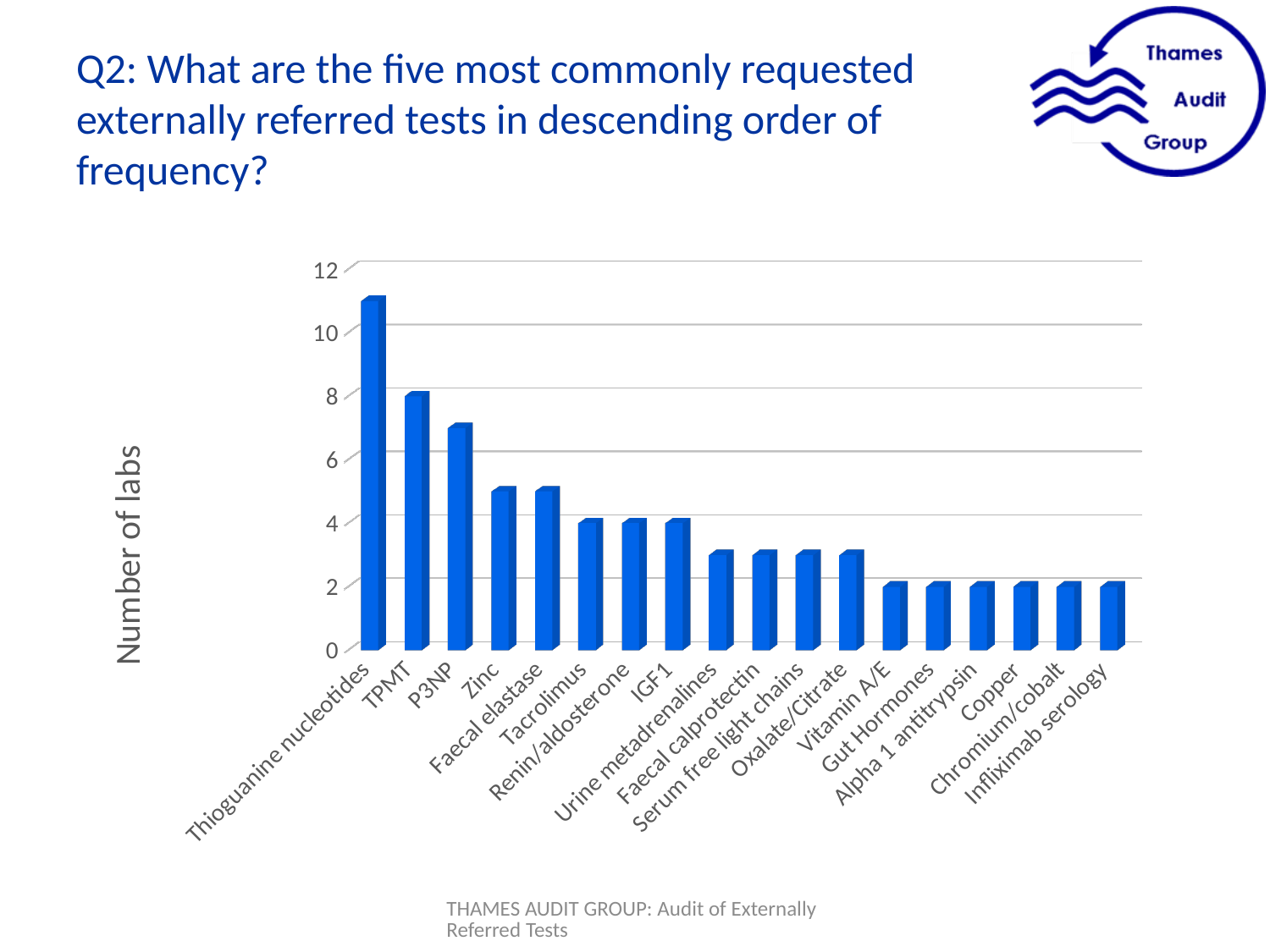
Is the value for Copper greater or less than 4? less How many tests (categories) are shown on the x axis? 18 Which has more labs, TPMT or P3NP? TPMT What kind of chart is shown on the slide? bar chart Which test has the highest number of labs? Thioguanine nucleotides What is the label of the vertical axis? Number of labs Is the value for Thioguanine nucleotides greater or less than 10? greater Do the values rise or fall moving left to right along the x axis? fall Is the value for Zinc greater or less than 6? less Which has more labs, Zinc or Tacrolimus? Zinc